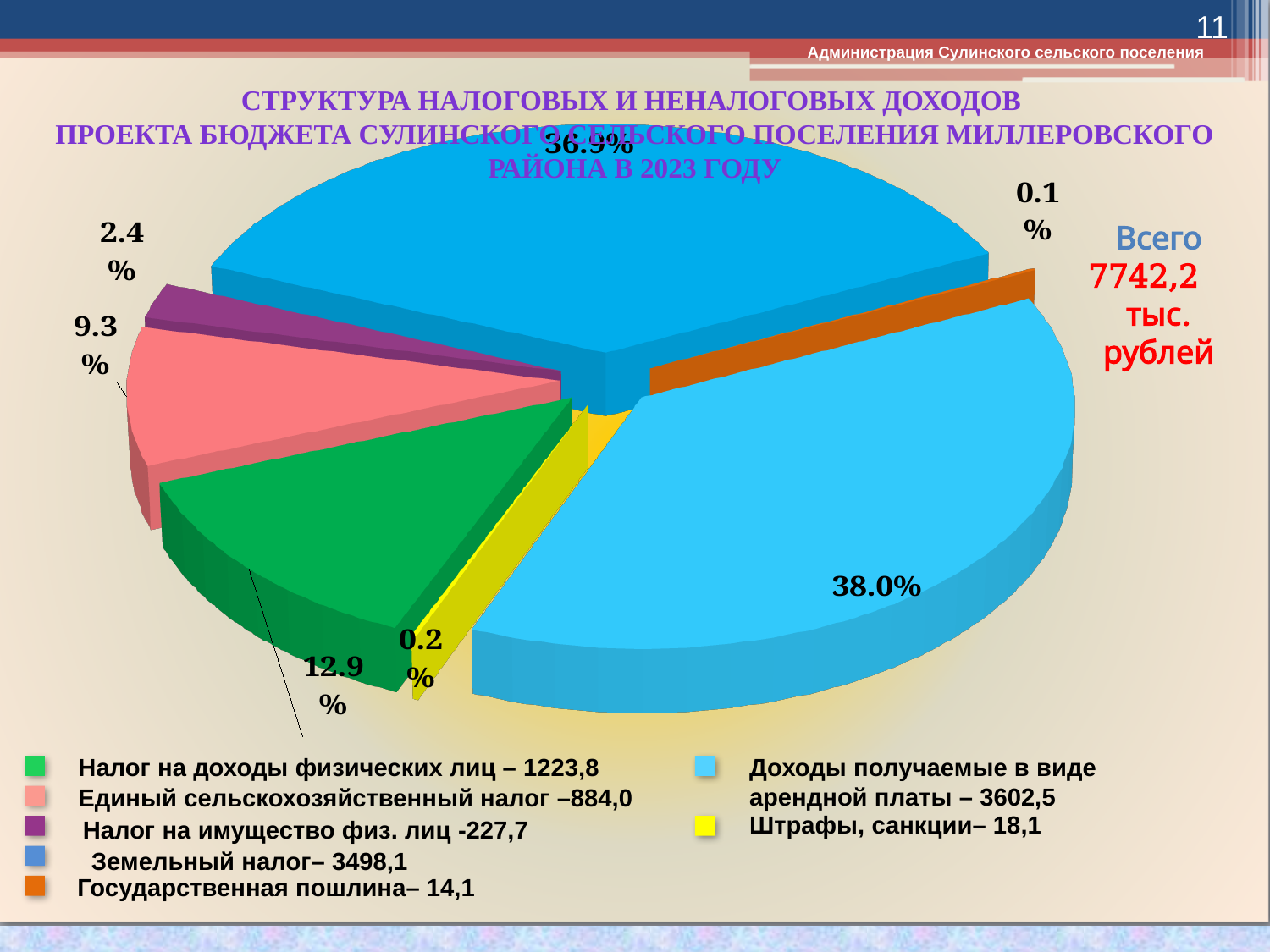
What share of the pie does "Налог на доходы физических лиц" have? 12.9% Which is larger, the share for "Единый сельскохозяйственный налог" or for "Налог на имущество физ. лиц"? Единый сельскохозяйственный налог What is the value for "Штрафы, санкции" shown in the legend? 18,1 Which category has the smallest slice of the pie? Государственная пошлина What kind of chart is shown on the slide? pie chart What share of the pie does "Налог на имущество физ. лиц" have? 2.4% What share of the pie does "Доходы получаемые в виде арендной платы" have? 38.0% How many slices does the pie chart have? 7 What is the value for "Земельный налог" shown in the legend? 3498,1 What total amount (Всего) is shown next to the pie chart? 7742,2 тыс. рублей Which category has the largest slice of the pie? Доходы получаемые в виде арендной платы